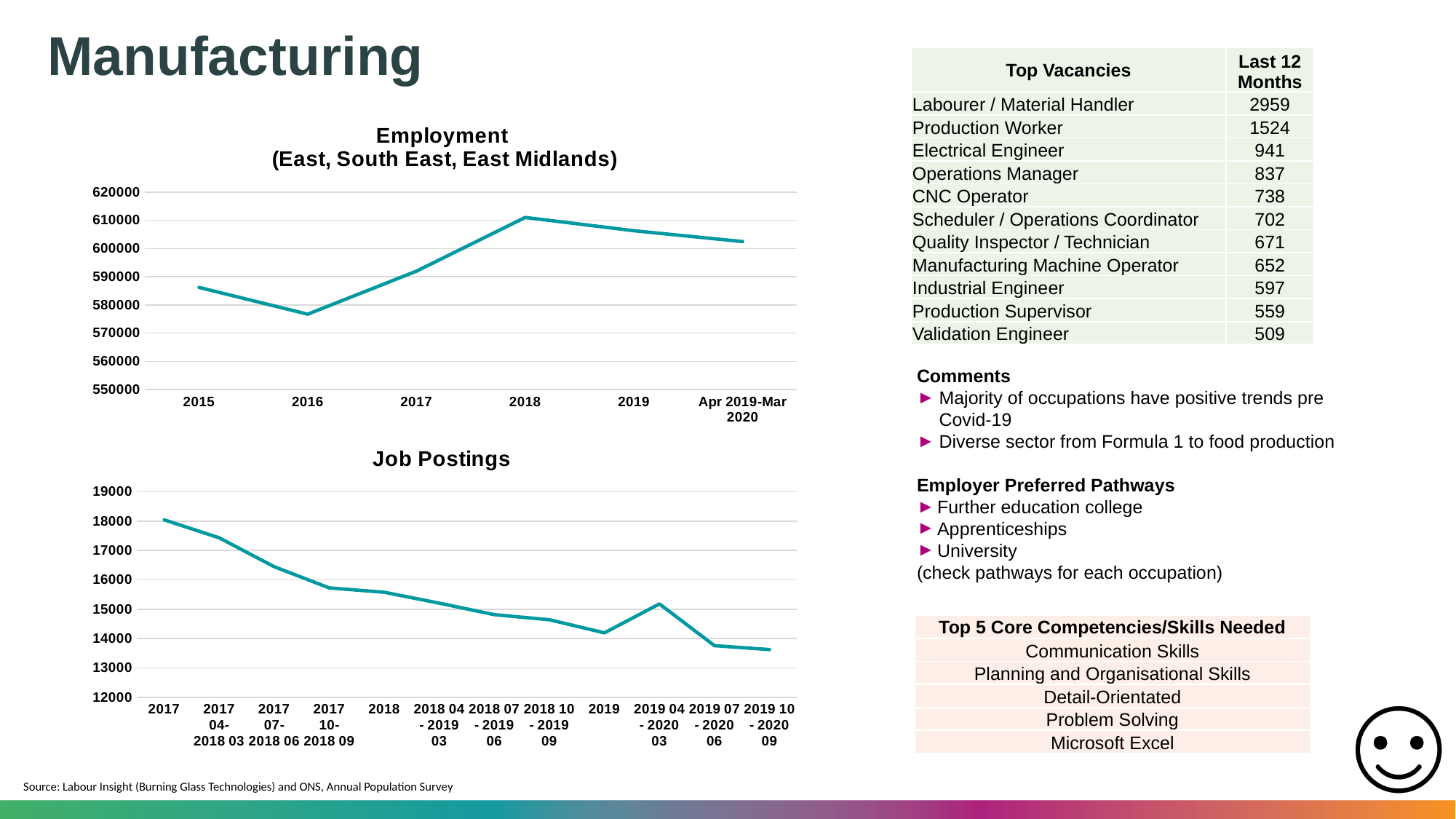
In the Employment (East, South East, East Midlands) chart, is the value for 2018 greater or less than 600000? greater How many data points are plotted in the Employment (East, South East, East Midlands) chart? 6 In the Employment (East, South East, East Midlands) chart, which is larger, the value for 2017 or the value for 2016? 2017 In the Employment (East, South East, East Midlands) chart, is the value for 2016 greater or less than 580000? less In the Job Postings chart, is the value for 2019 greater or less than 15000? less In the Employment (East, South East, East Midlands) chart, which year has the highest employment? 2018 What kind of chart is the Employment (East, South East, East Midlands) chart? line chart In the Job Postings chart, which period has the lowest number of job postings? 2019 10 - 2020 09 How many data points are plotted in the Job Postings chart? 12 In the Job Postings chart, do the values generally rise or fall from 2017 to 2019 10 - 2020 09? fall In the Job Postings chart, which period has the highest number of job postings? 2017 In the Employment (East, South East, East Midlands) chart, which year has the lowest employment? 2016